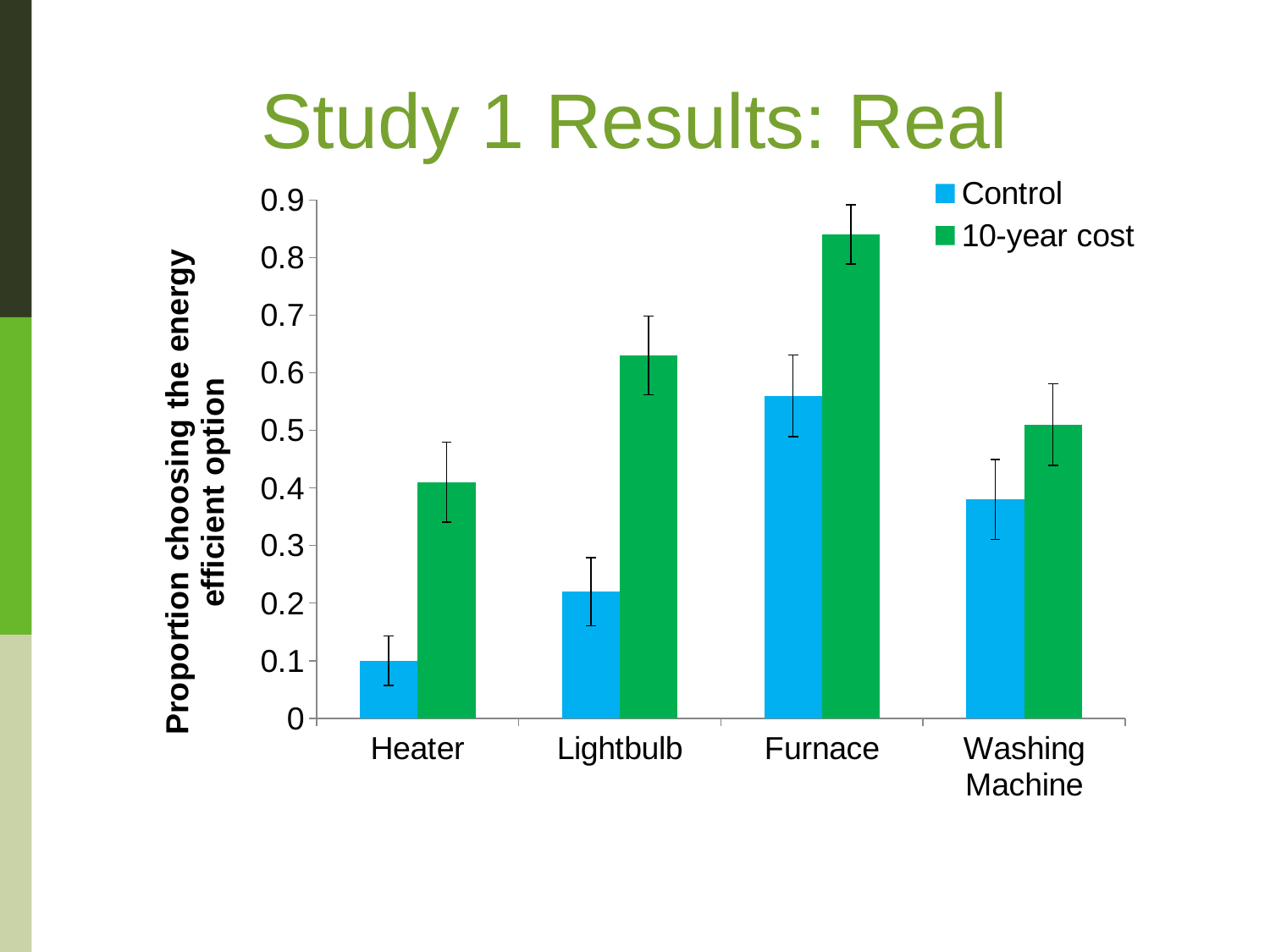
Which category has the highest value for the 10-year cost series? Furnace How many series does the legend list? 2 Which is larger: the Control value for Furnace or the 10-year cost value for Heater? Control value for Furnace Is the 10-year cost value for Lightbulb greater or less than 0.6? greater Which category has the lowest value for the 10-year cost series? Heater What is the label on the vertical axis? Proportion choosing the energy efficient option Is the Control value for Lightbulb greater or less than 0.3? less For Washing Machine, which series has the larger value, Control or 10-year cost? 10-year cost Is the 10-year cost value for Furnace greater or less than 0.8? greater Which category has the lowest value for the Control series? Heater What kind of chart is shown on the slide? bar chart How many product categories are shown on the x axis? 4